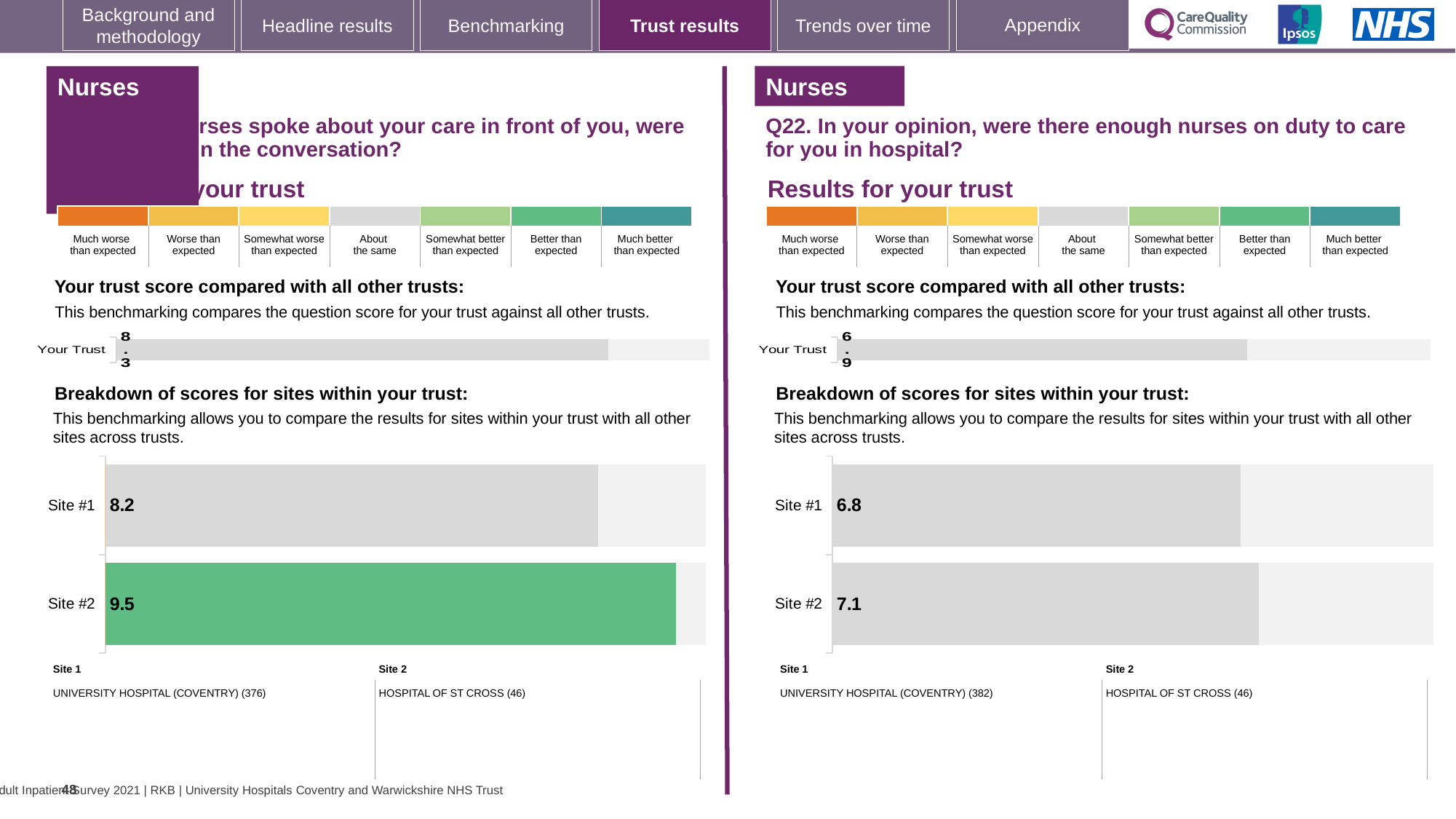
On the right-hand (Q22) site breakdown chart, what is the score for Site #1? 6.8 On the right-hand (Q22) site breakdown chart, what is the difference between the Site #2 and Site #1 scores? 0.3 On the right-hand (Q22) site breakdown chart, what is the score for Site #2? 7.1 On the left-hand site breakdown chart, what is the score for Site #1? 8.2 On the left-hand 'Your Trust' chart, what is the trust score shown? 8.3 On the left-hand site breakdown chart, what is the difference between the Site #2 and Site #1 scores? 1.3 How many sites are shown on the right-hand (Q22) site breakdown chart? 2 On the right-hand (Q22) site breakdown chart, which site has the lower score? Site #1 On the left-hand site breakdown chart, which site has the higher score? Site #2 On the left-hand site breakdown chart, what is the score for Site #2? 9.5 What type of chart is the left-hand site breakdown chart? Bar chart On the right-hand (Q22) 'Your Trust' chart, what is the trust score shown? 6.9